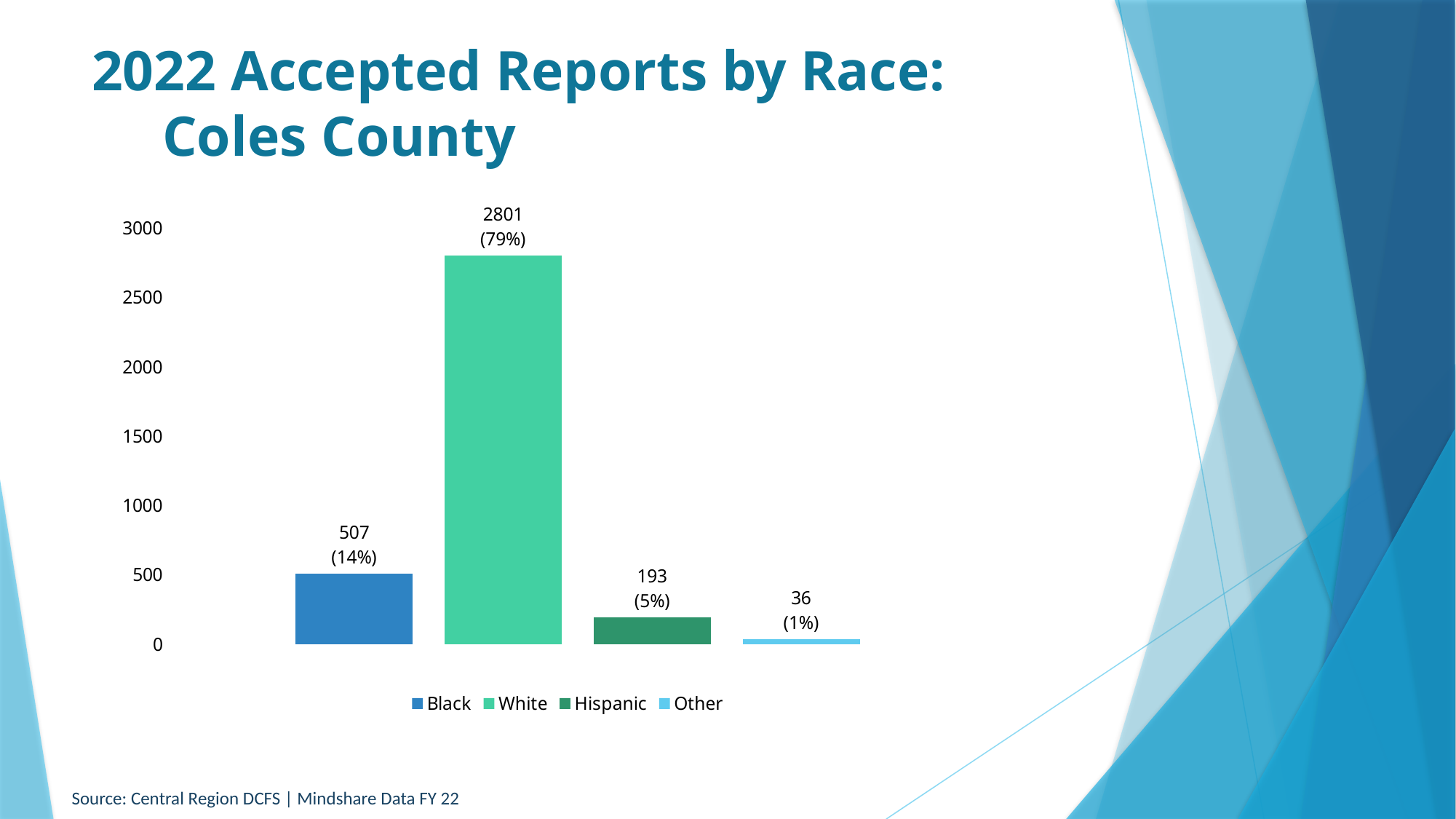
Which has more accepted reports, Black or Hispanic? Black Is the value for Black greater or less than 1000? less What percentage is shown for Hispanic? 5% What is the difference between the number of accepted reports for White and for Black? 2294 What is the source cited at the bottom of the slide? Central Region DCFS | Mindshare Data FY 22 How many accepted reports are shown for Black? 507 How many accepted reports are shown for Other? 36 How many race categories are shown in the chart? 4 Which race category has the highest number of accepted reports? White Which race category has the lowest number of accepted reports? Other How many accepted reports are shown for White? 2801 What kind of chart is shown on the slide? Bar chart